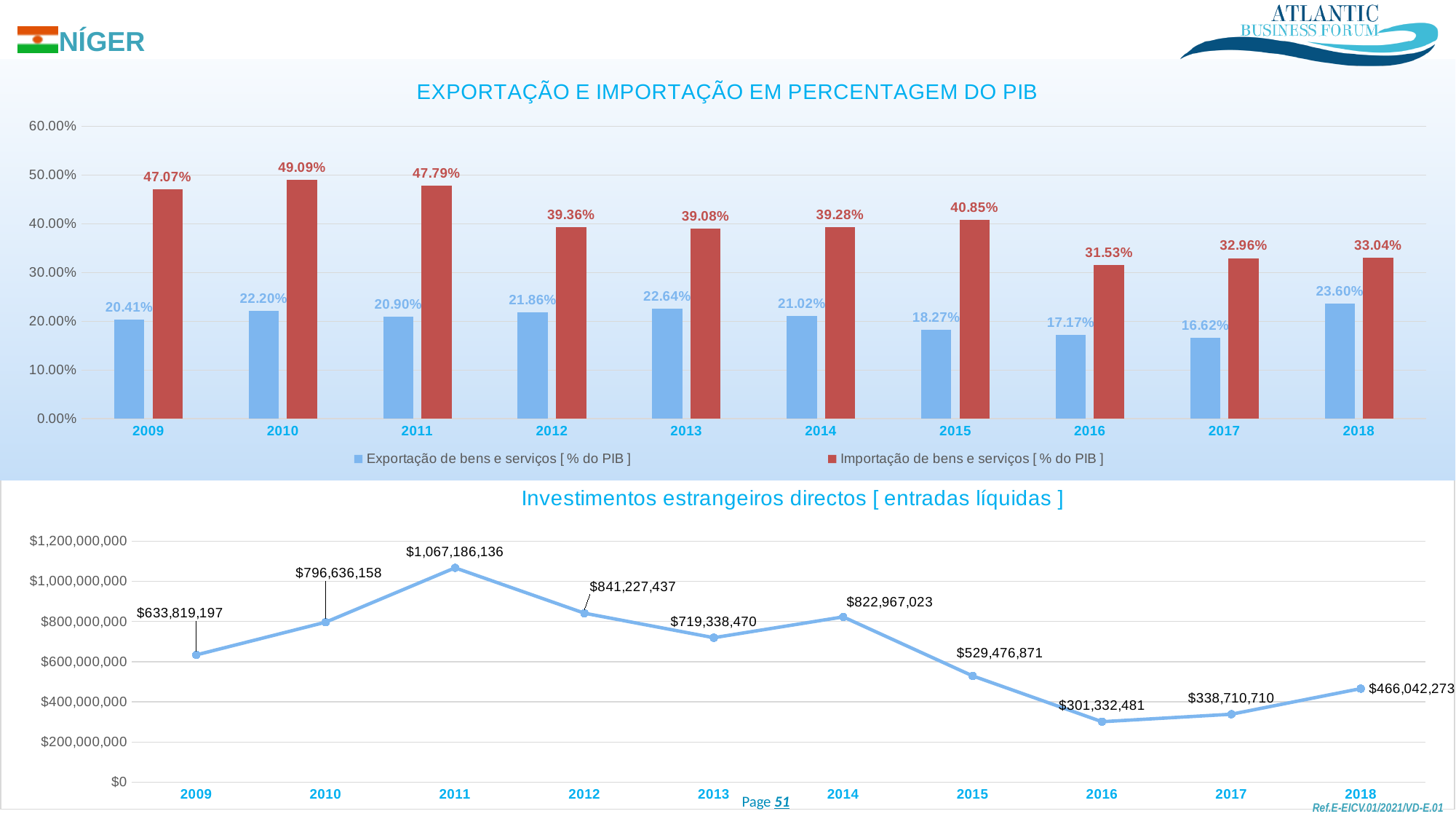
In the chart 'EXPORTAÇÃO E IMPORTAÇÃO EM PERCENTAGEM DO PIB', what is the value of Exportação de bens e serviços in 2017? 16.62% In the chart 'Investimentos estrangeiros directos [ entradas líquidas ]', which year has the lowest value? 2016 In the chart 'Investimentos estrangeiros directos [ entradas líquidas ]', what is the value for 2011? $1,067,186,136 In the chart 'EXPORTAÇÃO E IMPORTAÇÃO EM PERCENTAGEM DO PIB', what is the value of Importação de bens e serviços in 2010? 49.09% In the chart 'EXPORTAÇÃO E IMPORTAÇÃO EM PERCENTAGEM DO PIB', which year has the lowest Importação de bens e serviços value? 2016 In the chart 'EXPORTAÇÃO E IMPORTAÇÃO EM PERCENTAGEM DO PIB', which year has the highest Exportação de bens e serviços value? 2018 What kind of chart is 'Investimentos estrangeiros directos [ entradas líquidas ]'? Line chart In the chart 'EXPORTAÇÃO E IMPORTAÇÃO EM PERCENTAGEM DO PIB', how many series does the legend list? 2 In the chart 'Investimentos estrangeiros directos [ entradas líquidas ]', do the values rise or fall from 2014 to 2016? Fall In the chart 'Investimentos estrangeiros directos [ entradas líquidas ]', which is larger, the value for 2014 or the value for 2015? 2014 In the chart 'EXPORTAÇÃO E IMPORTAÇÃO EM PERCENTAGEM DO PIB', how many years are shown on the x axis? 10 In the chart 'EXPORTAÇÃO E IMPORTAÇÃO EM PERCENTAGEM DO PIB', what is the difference between Importação and Exportação in 2009? 26.66%